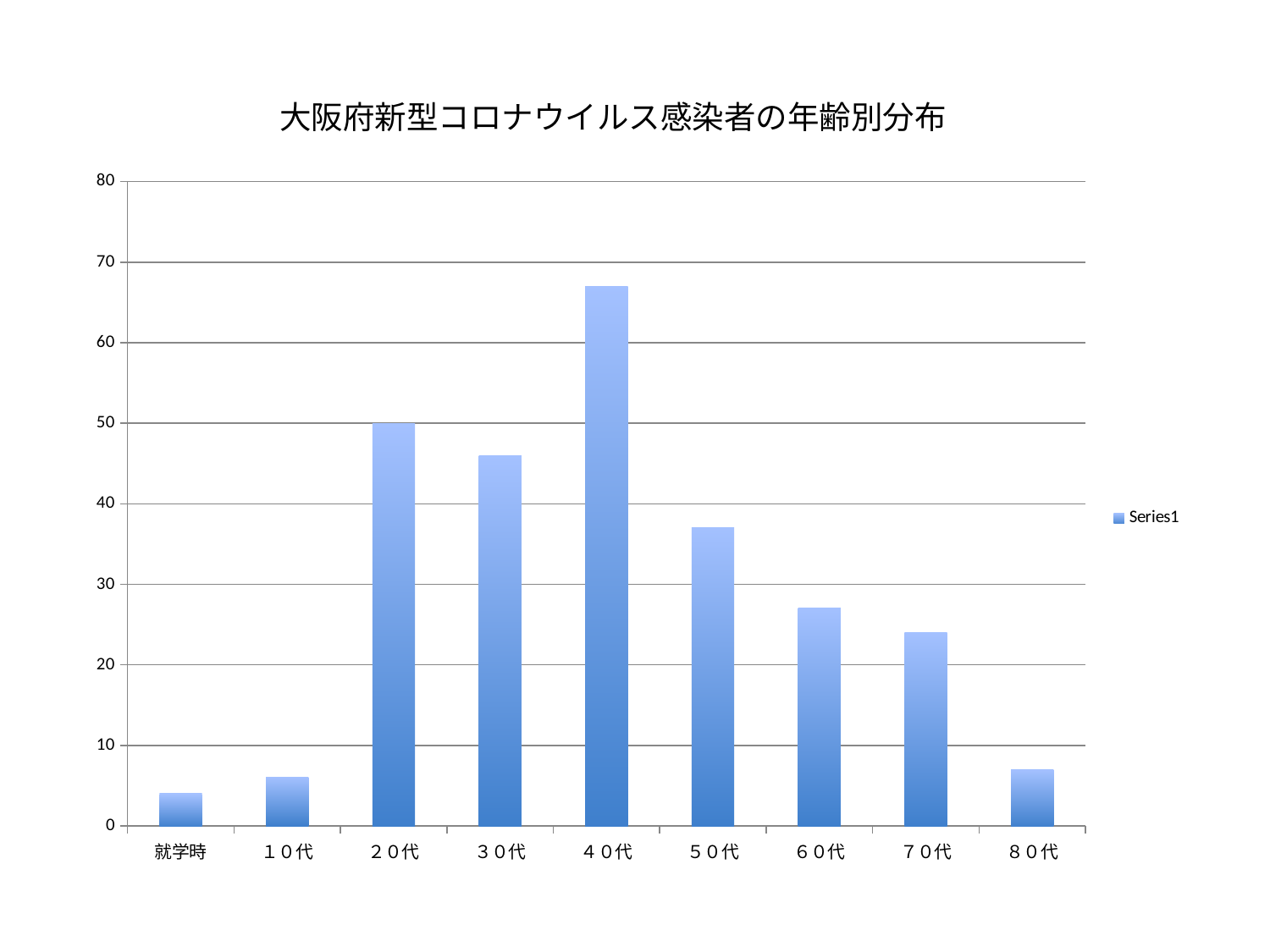
Which age category has the lowest value? 就学時 Is the value for ７０代 greater or less than 20? greater Is the value for ５０代 greater or less than 40? less How many age categories are shown on the x axis? 9 What is the name of the series shown in the legend? Series1 What kind of chart is shown on the slide? bar chart Which is larger, the value for ６０代 or the value for ８０代? ６０代 Which is larger, the value for ２０代 or the value for ３０代? ２０代 How many series does the legend list? 1 Is the value for ４０代 greater or less than 60? greater Which age category has the highest value? ４０代 What is the title of the chart? 大阪府新型コロナウイルス感染者の年齢別分布